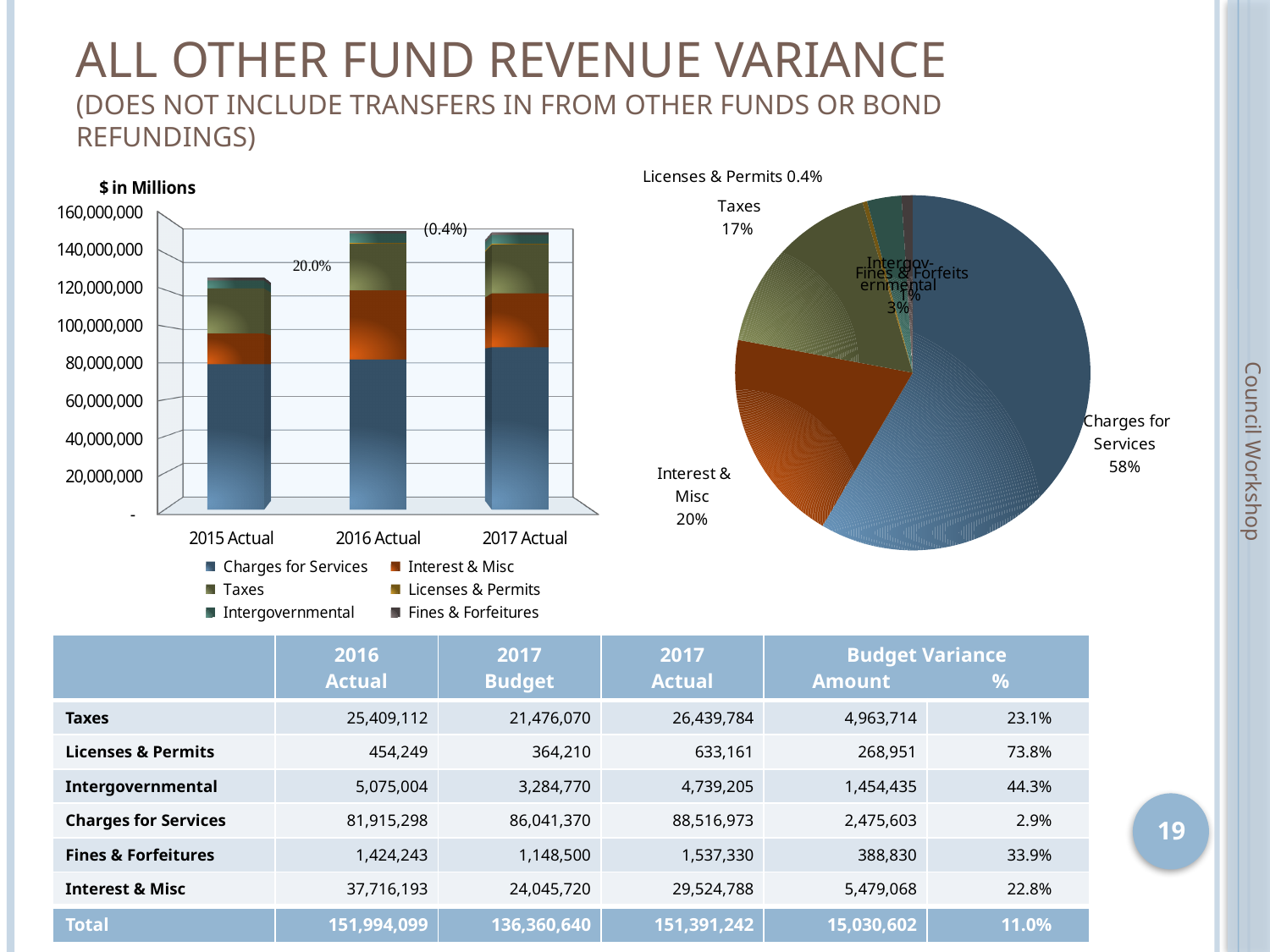
In the bar chart on the left, is the total for 2015 Actual greater or less than 140,000,000? less In the pie chart, which slice is the smallest? Licenses & Permits In the pie chart, what share does Taxes have? 17% What kind of chart is the chart on the left of the slide? Stacked bar chart How many series does the legend of the bar chart on the left list? 6 In the pie chart, how many percentage points larger is the Charges for Services share than the Interest & Misc share? 38 percentage points In the pie chart, what share does Charges for Services have? 58% In the pie chart, which slice is the largest? Charges for Services How many categories are shown on the x axis of the bar chart on the left? 3 In the pie chart, what share does Interest & Misc have? 20%